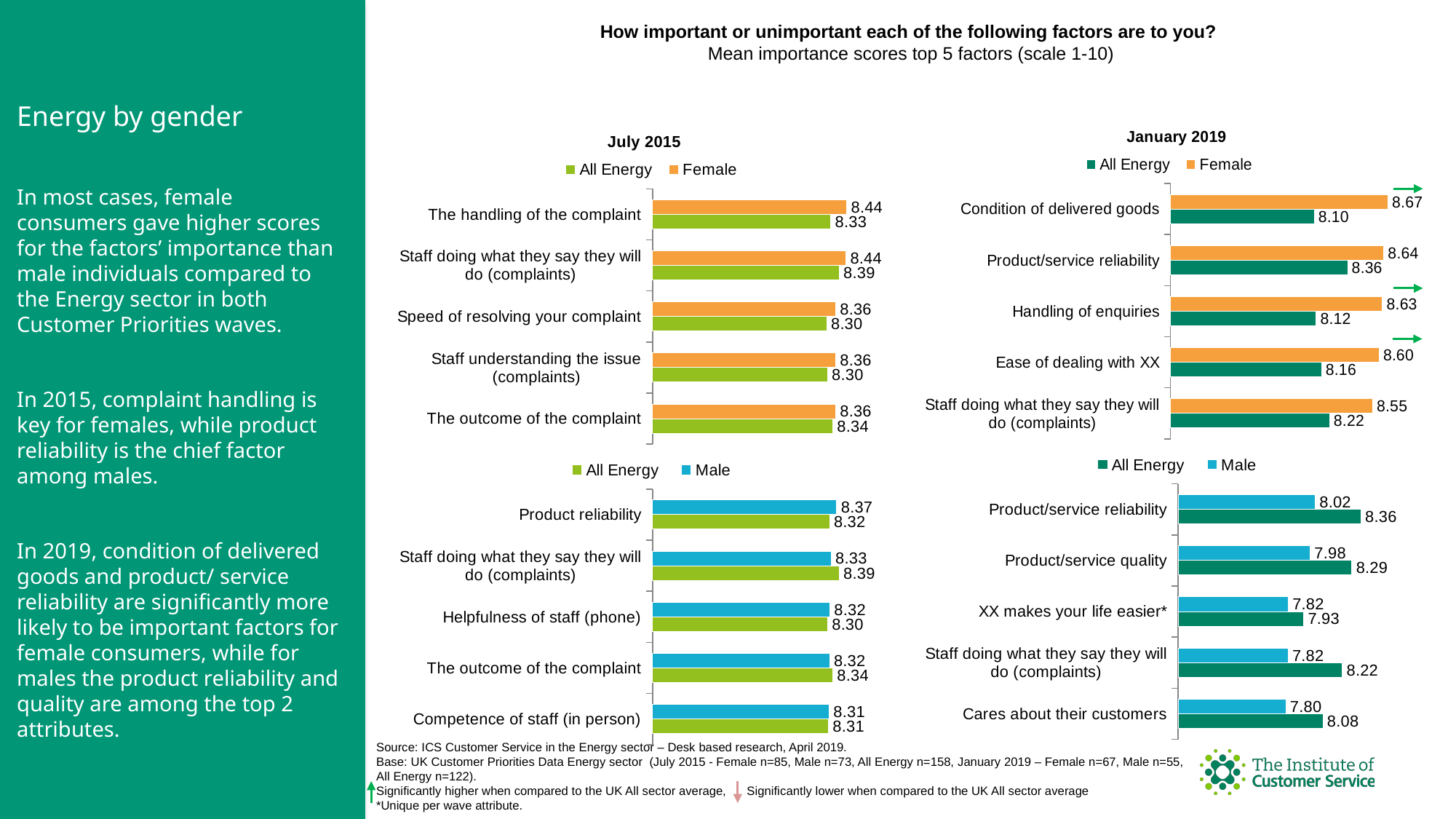
How many categories are shown in the January 2019 Male chart (bottom right)? 5 In the July 2015 Female chart (top left), what is the Female score for The handling of the complaint? 8.44 What type of chart is the January 2019 Female chart (top right)? Bar chart In the January 2019 Female chart (top right), what is the difference between the Female and All Energy scores for Condition of delivered goods? 0.57 In the January 2019 Male chart (bottom right), which category has the lowest Male score? Cares about their customers In the January 2019 Female chart (top right), which category has the highest Female score? Condition of delivered goods How many series does the legend of the July 2015 Female chart (top left) list? 2 In the July 2015 Male chart (bottom left), what is the Male score for Competence of staff (in person)? 8.31 In the January 2019 Male chart (bottom right), what is the difference between the All Energy and Male scores for Staff doing what they say they will do (complaints)? 0.40 In the July 2015 Male chart (bottom left), which is larger for Staff doing what they say they will do (complaints): the Male score or the All Energy score? All Energy In the January 2019 Female chart (top right), what is the All Energy score for Condition of delivered goods? 8.10 What are the two series named in the legend of the January 2019 Male chart (bottom right)? All Energy and Male